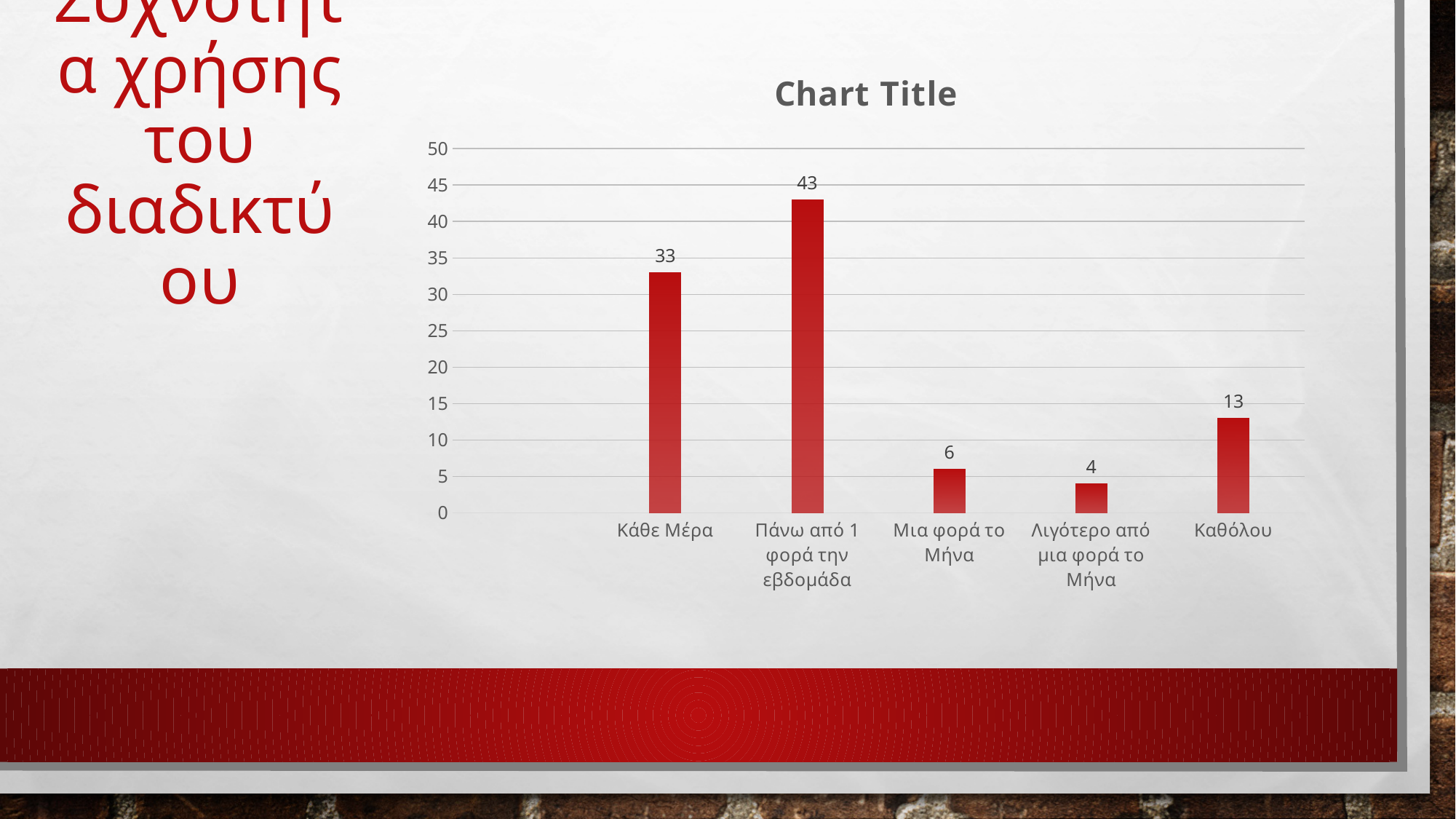
Which is larger, the value for Καθόλου or the value for Μια φορά το Μήνα? Καθόλου What is the value for Κάθε Μέρα? 33 What kind of chart is shown on the slide? Bar chart What is the value for Πάνω από 1 φορά την εβδομάδα? 43 Which category has the highest value? Πάνω από 1 φορά την εβδομάδα What is the value for Καθόλου? 13 Which category has the lowest value? Λιγότερο από μια φορά το Μήνα How many categories are shown on the x axis? 5 What is the difference between the values for Πάνω από 1 φορά την εβδομάδα and Κάθε Μέρα? 10 What is the value for Λιγότερο από μια φορά το Μήνα? 4 What is the title of the chart? Chart Title What is the value for Μια φορά το Μήνα? 6